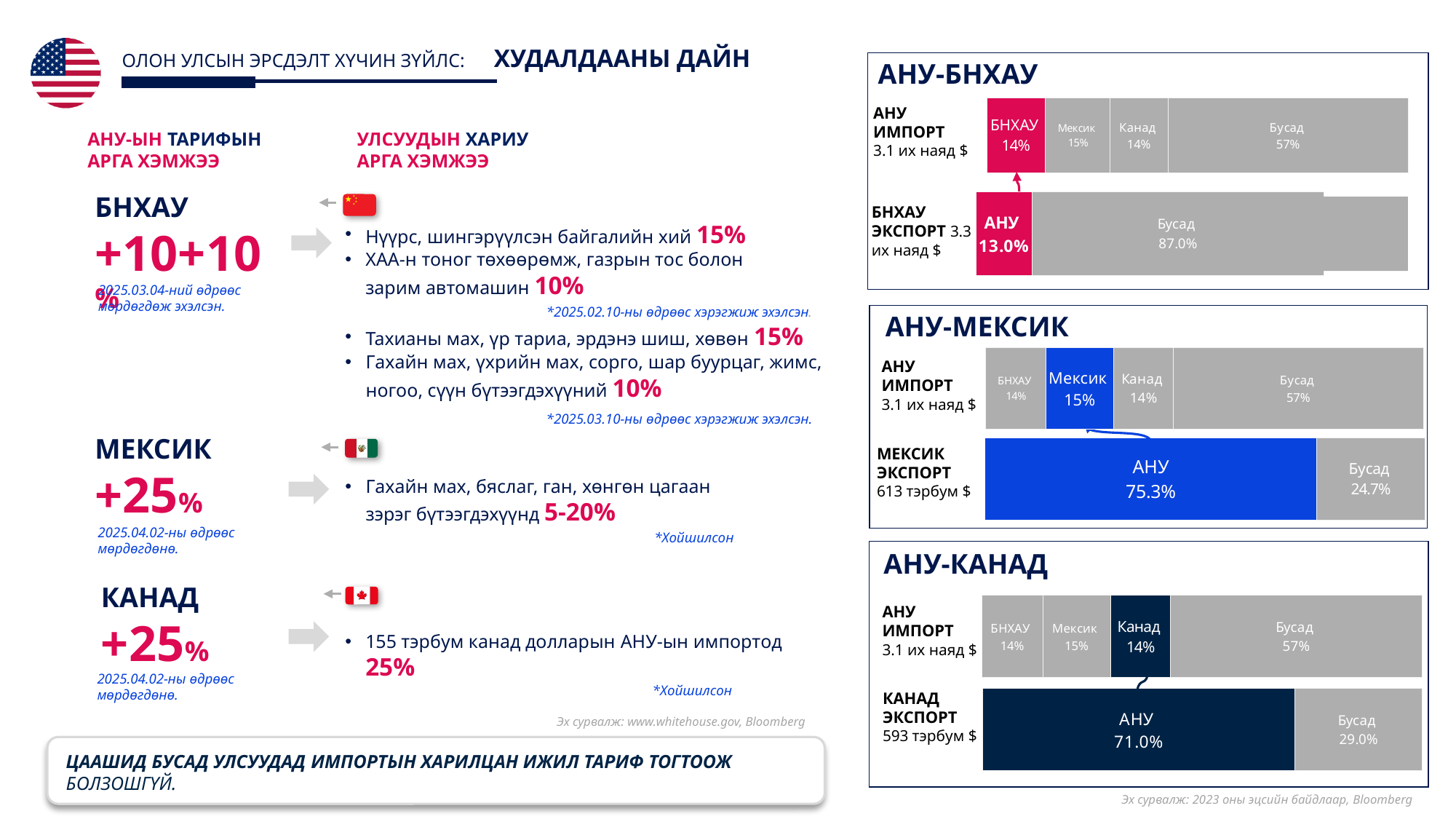
Which is larger: the share of Мексик экспорт going to АНУ (АНУ-МЕКСИК chart) or the share of Канад экспорт going to АНУ (АНУ-КАНАД chart)? Мексик экспорт to АНУ (75.3%) In the АНУ-БНХАУ chart, what share of БНХАУ экспорт goes to АНУ? 13.0% How many segments does the АНУ импорт bar have in the АНУ-БНХАУ chart? 4 In the АНУ-БНХАУ chart, what share of БНХАУ экспорт goes to Бусад? 87.0% In the АНУ-КАНАД chart, what share of АНУ импорт comes from Канад? 14% In the АНУ-МЕКСИК chart, which segment of the АНУ импорт bar is the largest? Бусад In the АНУ-МЕКСИК chart, what is the difference between the АНУ and Бусад shares of Мексик экспорт? 50.6 percentage points In the АНУ-БНХАУ chart, what is the total value of АНУ импорт shown next to the bar? 3.1 их наяд $ In the АНУ-МЕКСИК chart, what share of Мексик экспорт goes to АНУ? 75.3% In the АНУ-КАНАД chart, what share of Канад экспорт goes to Бусад? 29.0% In the АНУ-БНХАУ chart, which segment of the АНУ импорт bar is the smallest among the named countries? БНХАУ and Канад (14% each) What type of chart is used in the АНУ-КАНАД panel? Stacked bar chart